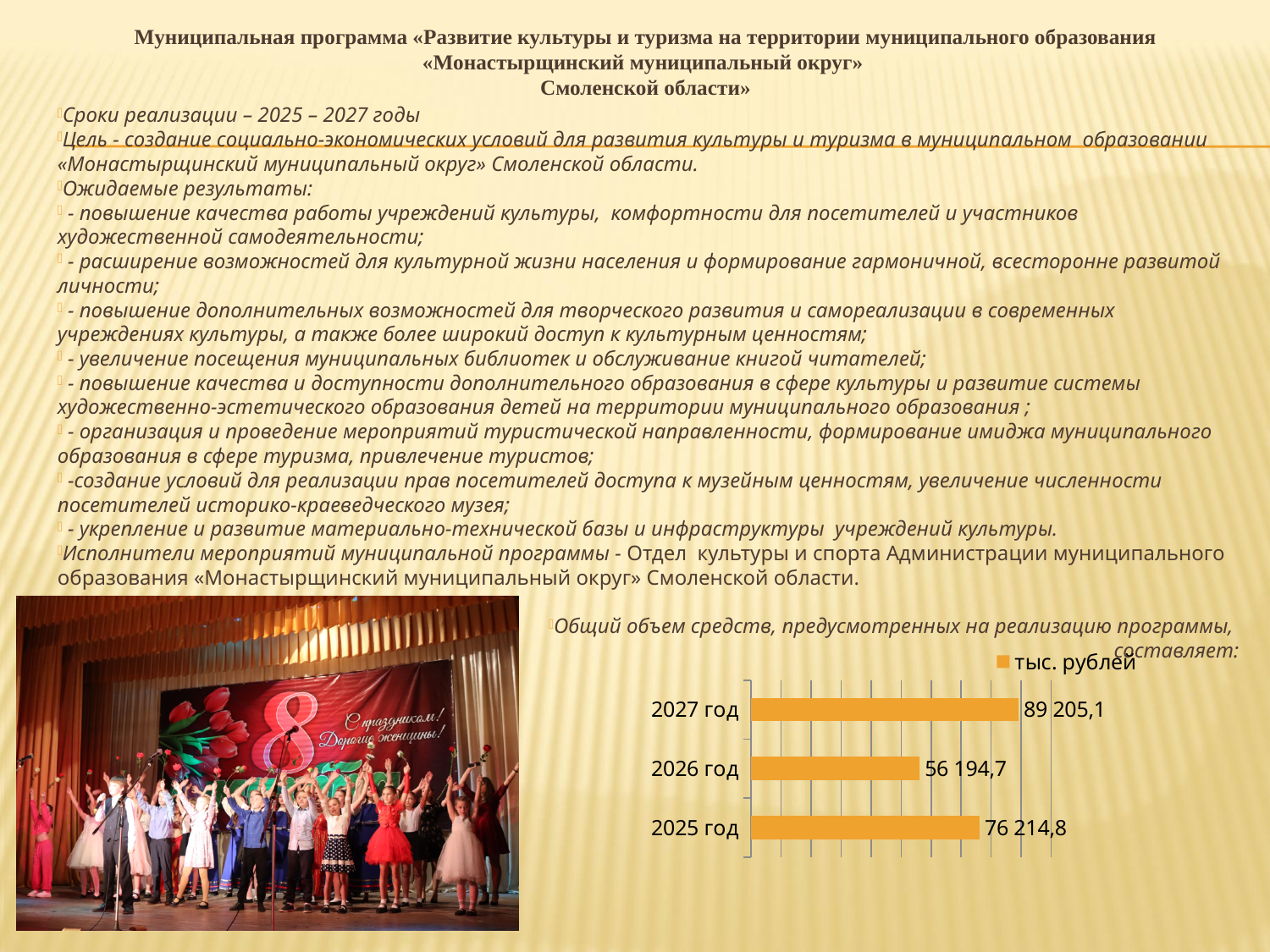
What is the difference between the values for 2027 год and 2025 год? 12 990,3 What is the difference between the values for 2025 год and 2026 год? 20 020,1 What is the value for 2025 год in the chart? 76 214,8 Which is larger, the value for 2025 год or the value for 2026 год? 2025 год Which year has the lowest value in the chart? 2026 год What kind of chart is shown on the slide? bar chart Which year has the highest value in the chart? 2027 год How many categories (years) are shown in the chart? 3 What is the value for 2027 год in the chart? 89 205,1 How many series does the chart legend list? 1 What is the value for 2026 год in the chart? 56 194,7 What is the legend entry of the chart? тыс. рублей